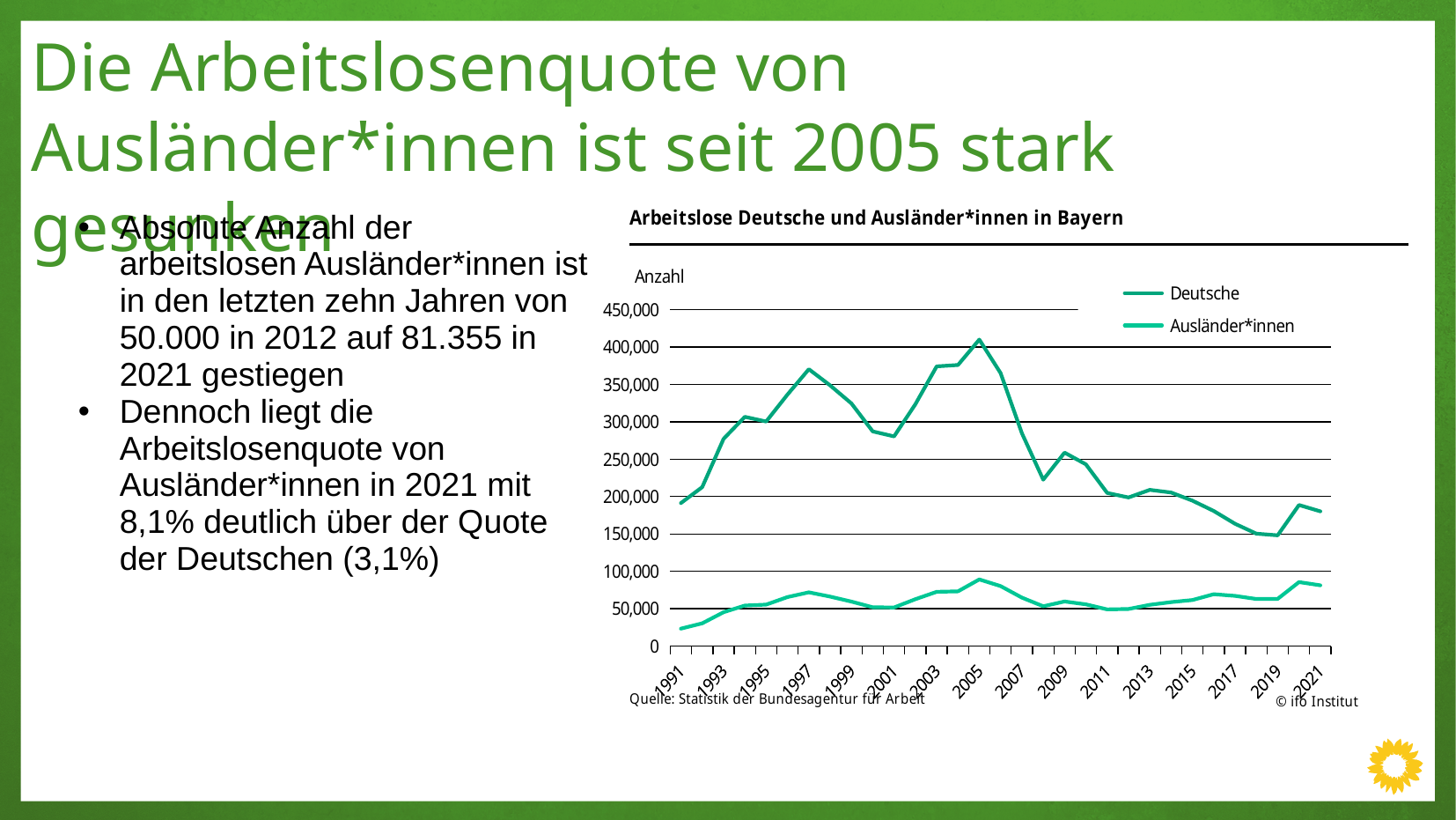
Is the value for Ausländer*innen in 1991 greater or less than 50,000? less Is the value for Deutsche in 2005 greater or less than 350,000? greater In which year does the Deutsche series reach its highest value? 2005 What kind of chart is shown on the slide? line chart What are the two series named in the chart legend? Deutsche and Ausländer*innen Does the Deutsche series rise or fall between 2005 and 2019? fall Which series has the larger value in 2005, Deutsche or Ausländer*innen? Deutsche What is the title of the chart? Arbeitslose Deutsche und Ausländer*innen in Bayern Is the value for Ausländer*innen in 2021 greater or less than 50,000? greater How many series does the chart legend list? 2 In which year is the Ausländer*innen series at its lowest value? 1991